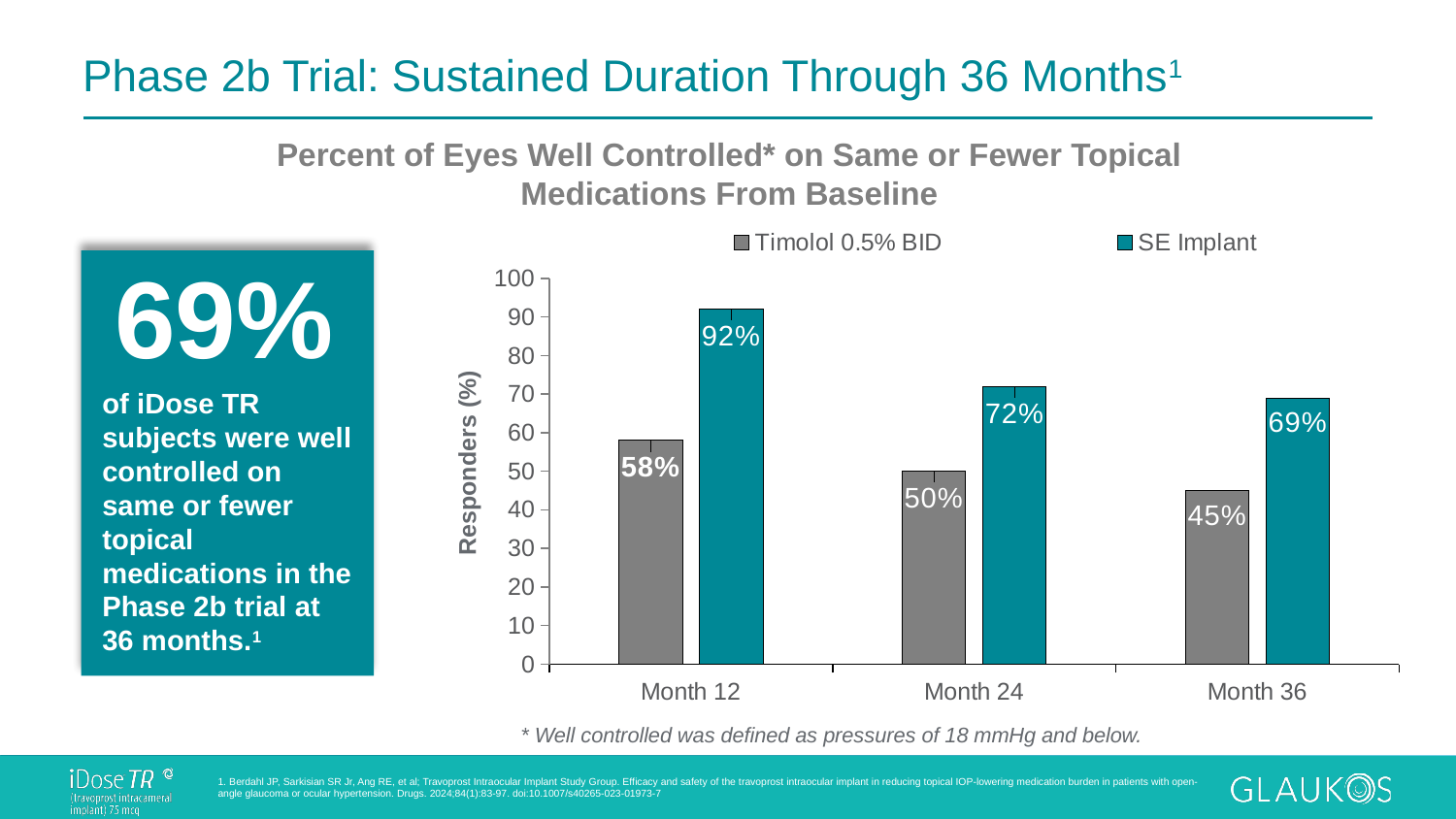
What is the value for SE Implant at Month 24? 72% Do the SE Implant values rise or fall from Month 12 to Month 36? Fall At which time point is the Timolol 0.5% BID value lowest? Month 36 At which time point is the SE Implant value highest? Month 12 Which is larger at Month 24: Timolol 0.5% BID or SE Implant? SE Implant What is the value for SE Implant at Month 12? 92% How many series does the legend list? 2 What is the difference between the SE Implant and Timolol 0.5% BID values at Month 12? 34% What is the difference between the SE Implant and Timolol 0.5% BID values at Month 36? 24% What kind of chart is shown? Bar chart How many time points are shown on the x axis? 3 What is the value for Timolol 0.5% BID at Month 36? 45%